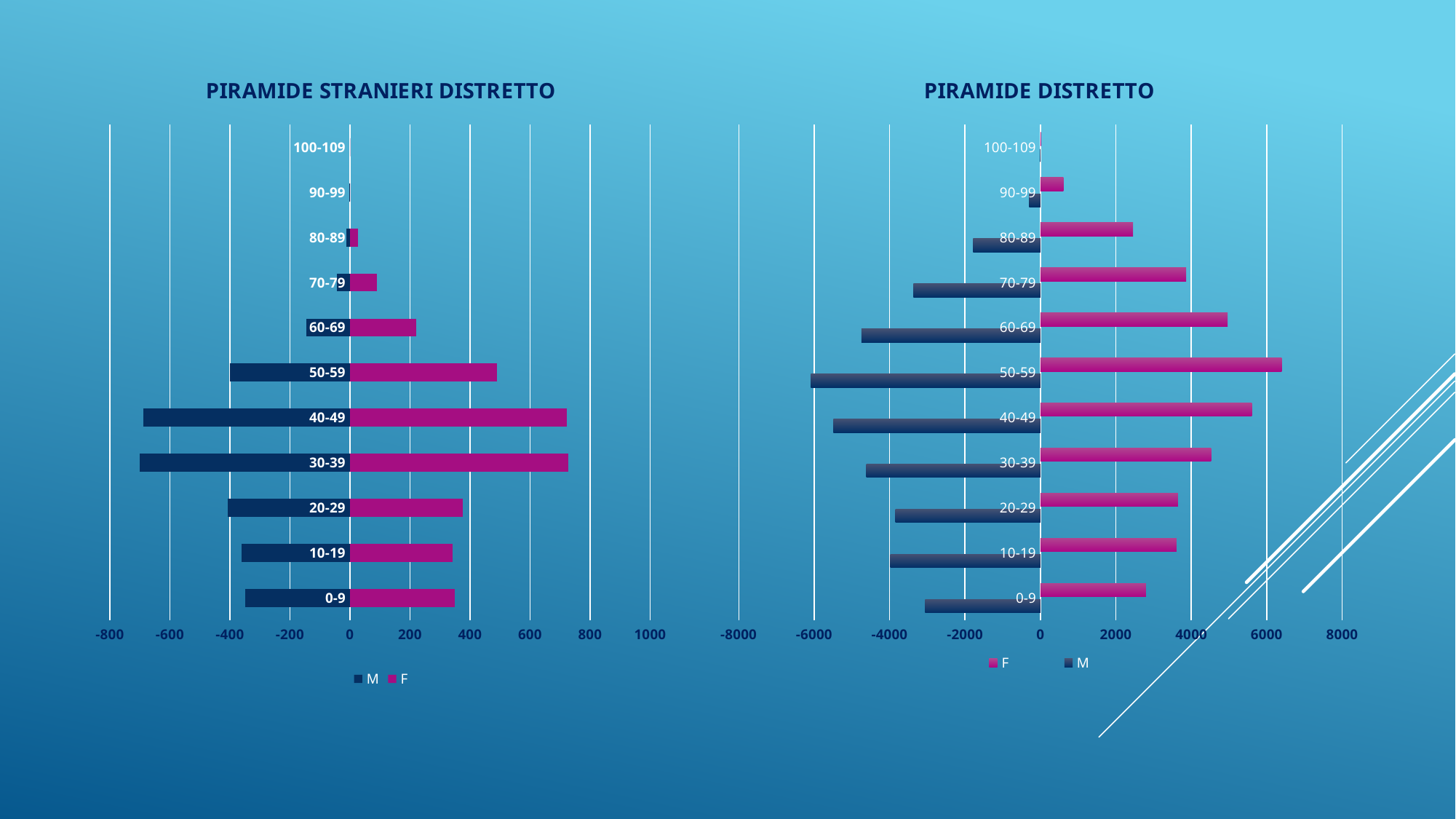
In the PIRAMIDE STRANIERI DISTRETTO chart, which is larger, the F value for 50-59 or the F value for 20-29? 50-59 In the PIRAMIDE DISTRETTO chart, is the F value for 0-9 greater or less than 2000? greater In the PIRAMIDE STRANIERI DISTRETTO chart, do the F values rise or fall going from 50-59 up to 100-109? fall In the PIRAMIDE STRANIERI DISTRETTO chart, is the F value for 20-29 greater or less than 400? less In the PIRAMIDE DISTRETTO chart, is the F value for 50-59 greater or less than 6000? greater In the PIRAMIDE DISTRETTO chart, which age category has the highest F value? 50-59 In the PIRAMIDE DISTRETTO chart, which is larger, the F value for 60-69 or the F value for 20-29? 60-69 How many series does the legend of the PIRAMIDE STRANIERI DISTRETTO chart list? 2 How many age categories does the PIRAMIDE DISTRETTO chart show? 11 What kind of chart is the PIRAMIDE STRANIERI DISTRETTO chart? bar chart